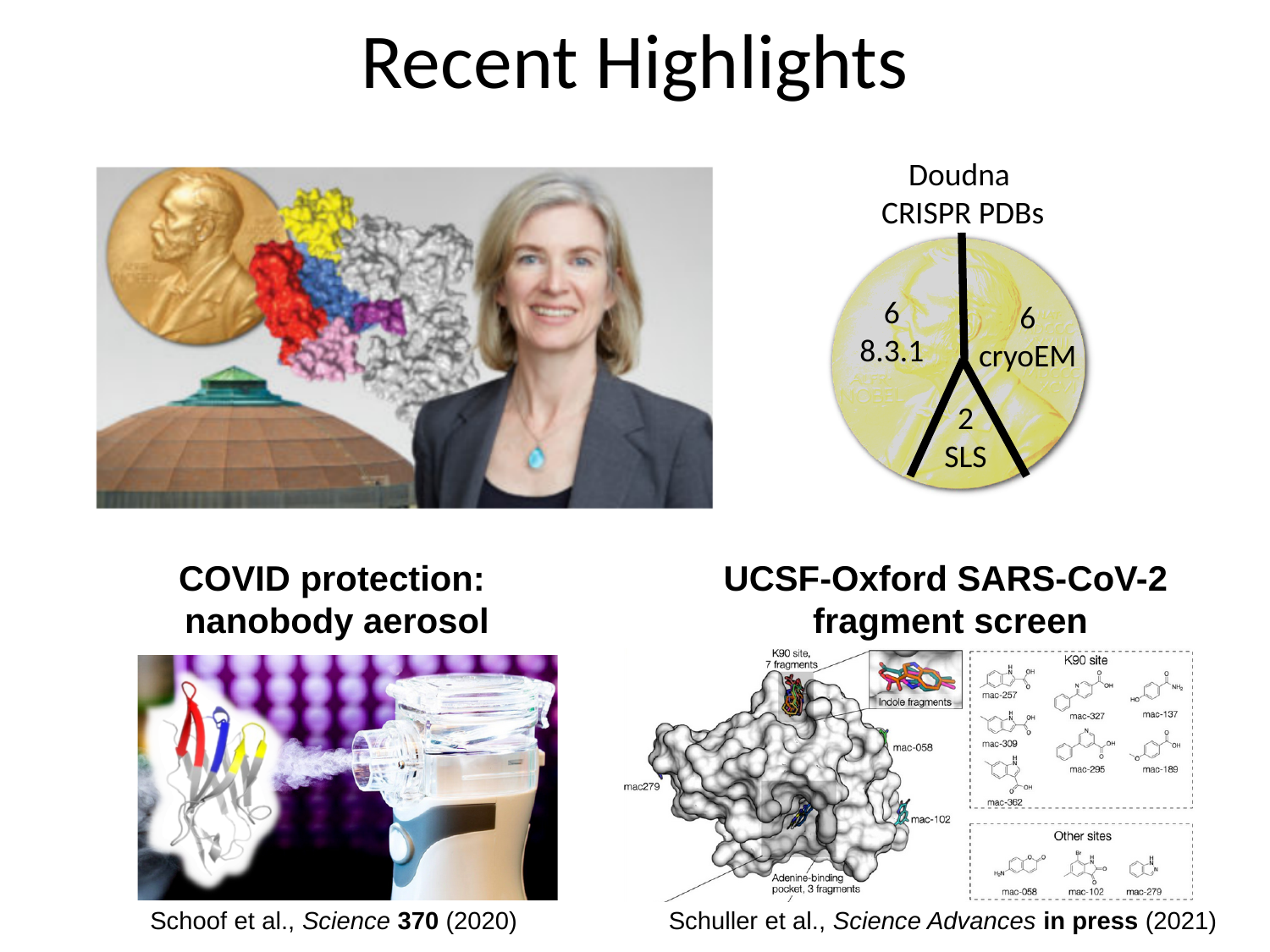
In the Doudna CRISPR PDBs chart, how many PDBs are attributed to SLS? 2 What kind of chart is the Doudna CRISPR PDBs chart? pie chart In the Doudna CRISPR PDBs chart, what is the difference between the cryoEM value and the SLS value? 4 What is the total number of PDBs across all slices of the Doudna CRISPR PDBs chart? 14 How many slices does the Doudna CRISPR PDBs pie chart have? 3 In the Doudna CRISPR PDBs chart, how many PDBs are attributed to cryoEM? 6 In the Doudna CRISPR PDBs chart, how many PDBs are attributed to 8.3.1? 6 Which slice of the Doudna CRISPR PDBs chart has the smallest value? SLS What is the title of the pie chart on the slide? Doudna CRISPR PDBs What image is the Doudna CRISPR PDBs pie chart drawn over? A Nobel medal In the Doudna CRISPR PDBs chart, which is larger, the 8.3.1 slice or the SLS slice? 8.3.1 In the Doudna CRISPR PDBs chart, do the 8.3.1 and cryoEM slices have the same value? Yes